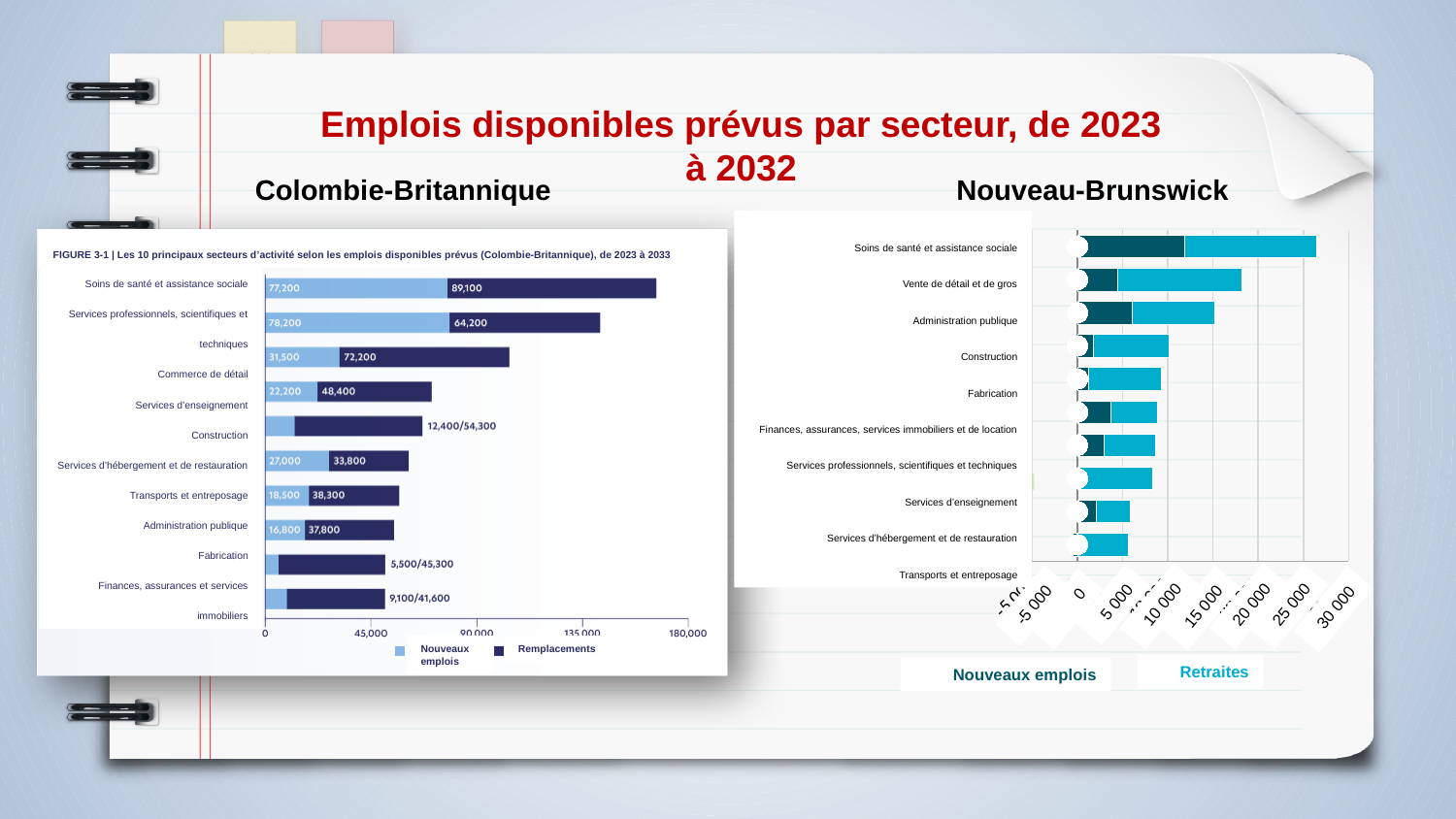
On the Colombie-Britannique chart, what is the total of the stacked bar for Transports et entreposage? 56,800 On the Colombie-Britannique chart, which is larger: the Nouveaux emplois value for Administration publique or for Services d'hébergement et de restauration? Services d'hébergement et de restauration On the Colombie-Britannique chart, what is the Nouveaux emplois value for Fabrication? 5,500 On the Colombie-Britannique chart, what is the Remplacements value for Construction? 54,300 On the Colombie-Britannique chart, what is the Nouveaux emplois value for Soins de santé et assistance sociale? 77,200 On the Nouveau-Brunswick chart, how many series does the legend list? 2 On the Colombie-Britannique chart, which sector has the highest Remplacements value? Soins de santé et assistance sociale On the Colombie-Britannique chart, what is the difference between the Remplacements and Nouveaux emplois values for Services d'enseignement? 26,200 On the Colombie-Britannique chart, what is the Remplacements value for Commerce de détail? 72,200 On the Colombie-Britannique chart, which sector has the lowest Nouveaux emplois value? Fabrication On the Nouveau-Brunswick chart, is the total bar for Vente de détail et de gros greater or less than 20 000? less On the Nouveau-Brunswick chart, which sector has the longest bar? Soins de santé et assistance sociale